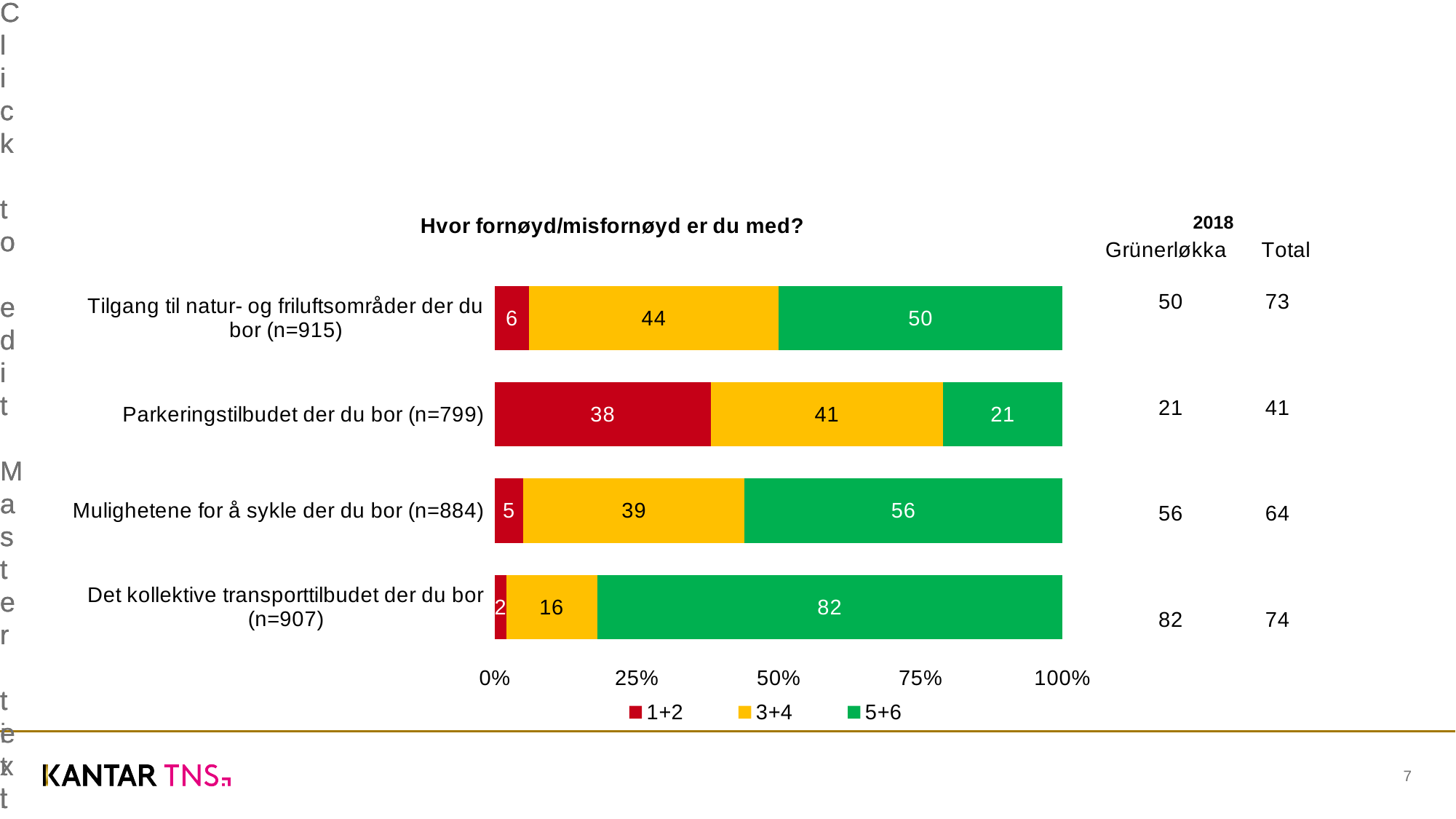
What is the title of the chart? Hvor fornøyd/misfornøyd er du med? Which category has the lowest 5+6 value? Parkeringstilbudet der du bor (n=799) How many categories are shown in the chart? 4 What is the difference between the 5+6 values for 'Mulighetene for å sykle der du bor (n=884)' and 'Tilgang til natur- og friluftsområder der du bor (n=915)'? 6 Which is larger: the 3+4 value for 'Parkeringstilbudet der du bor (n=799)' or the 3+4 value for 'Mulighetene for å sykle der du bor (n=884)'? Parkeringstilbudet der du bor (n=799) How many series does the legend list? 3 What is the total of the stacked bar for 'Parkeringstilbudet der du bor (n=799)'? 100 What is the value of the 3+4 series for 'Tilgang til natur- og friluftsområder der du bor (n=915)'? 44 What is the value of the 1+2 series for 'Parkeringstilbudet der du bor (n=799)'? 38 What kind of chart is shown on the slide? Stacked bar chart Which category has the highest 5+6 value? Det kollektive transporttilbudet der du bor (n=907) What is the value of the 5+6 series for 'Det kollektive transporttilbudet der du bor (n=907)'? 82